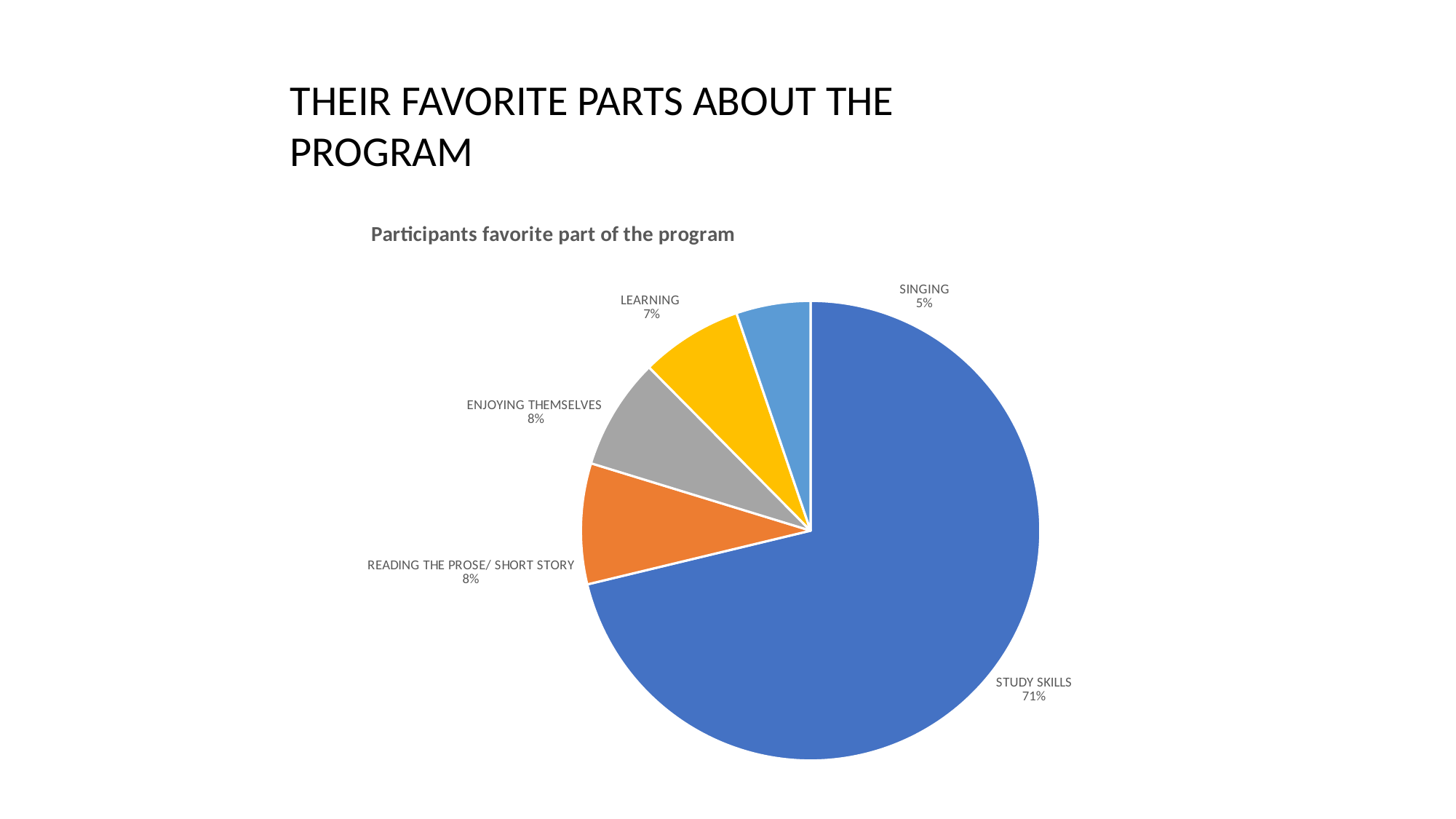
Which category has the smallest slice of the pie? SINGING What type of chart is shown on the slide? Pie chart What share of the pie does STUDY SKILLS represent? 71% What is the difference in percentage points between STUDY SKILLS and ENJOYING THEMSELVES? 63 What colour is the STUDY SKILLS slice? Blue How many categories are shown in the pie chart? 5 Which is larger, the share for LEARNING or the share for SINGING? LEARNING What percentage is shown for READING THE PROSE/ SHORT STORY? 8% What percentage is shown for LEARNING? 7% What percentage is shown for SINGING? 5% Which category has the largest slice of the pie? STUDY SKILLS What is the title of the chart? Participants favorite part of the program